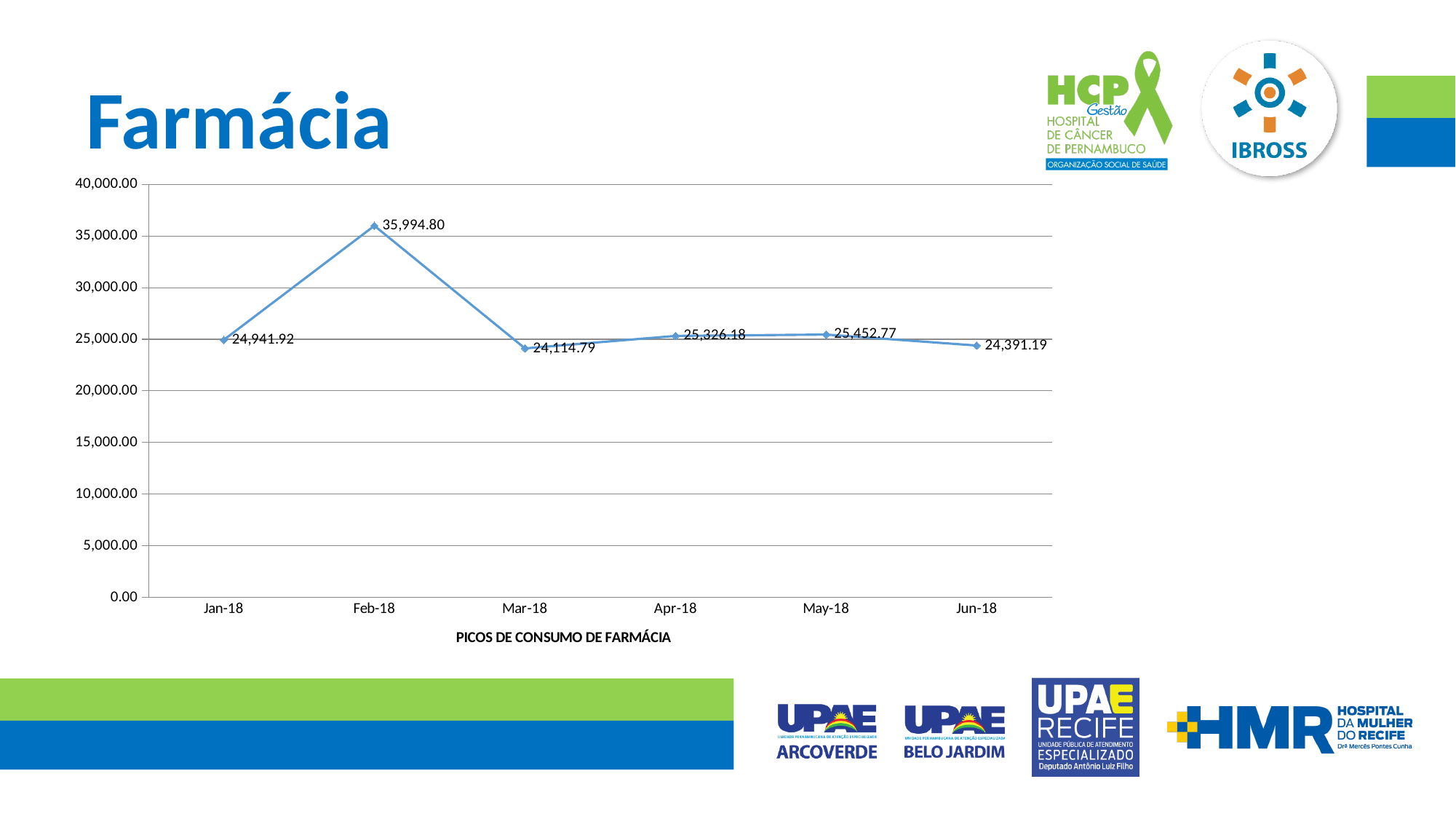
What is the difference between the values for May-18 and Apr-18? 126.59 Which month has the lowest value? Mar-18 How many months are plotted on the chart? 6 Which is larger, the value for Apr-18 or the value for May-18? May-18 What kind of chart is shown on the slide? line chart What is the value for Feb-18? 35,994.80 Which month has the highest value? Feb-18 What is the difference between the values for Feb-18 and Jan-18? 11,052.88 Is the value for Feb-18 greater or less than 35,000.00? greater What is the value for Mar-18? 24,114.79 What is the value for Jun-18? 24,391.19